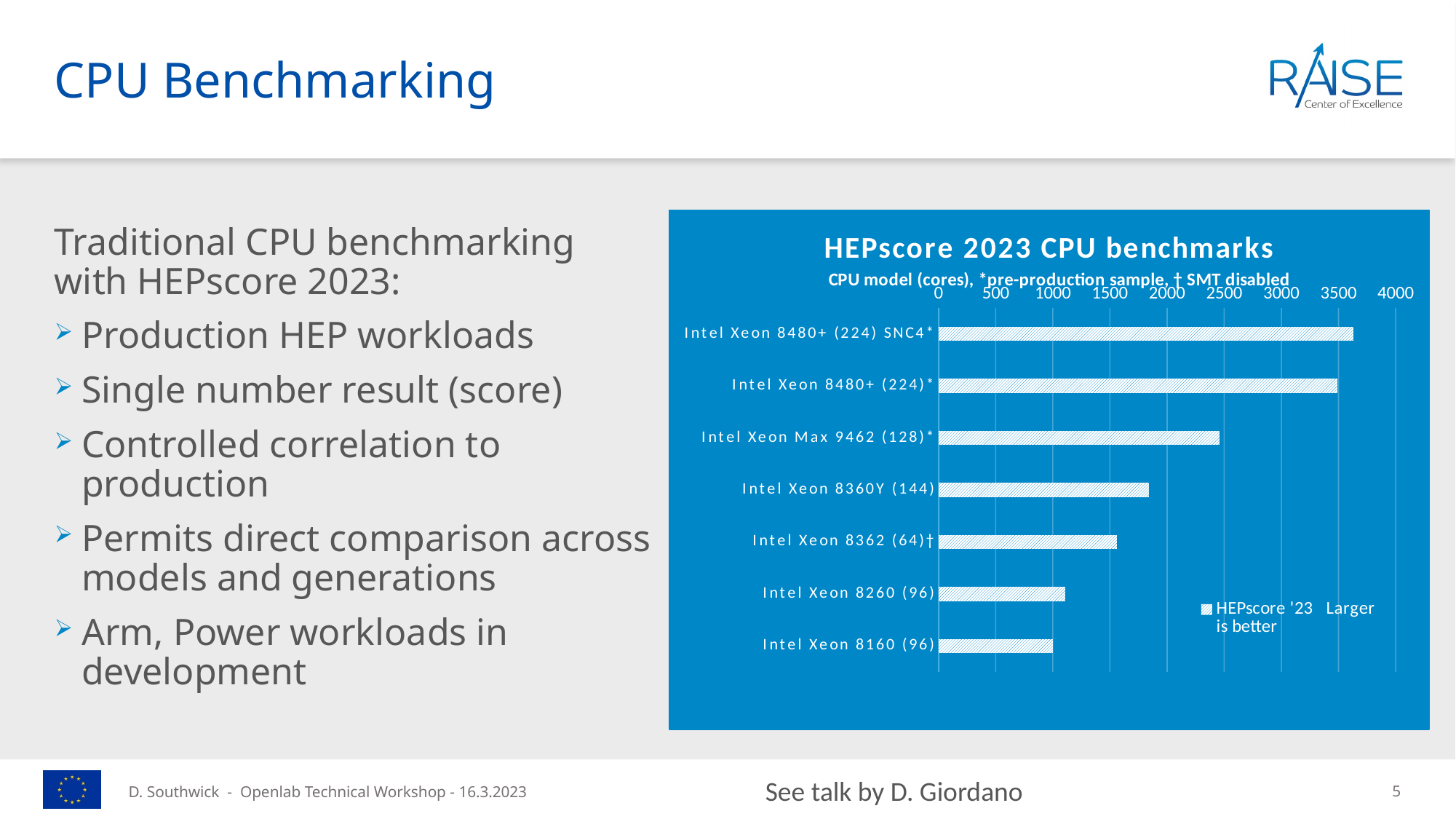
Is the value for Intel Xeon 8260 (96) greater or less than 1000? greater What is the name of the series shown in the chart legend? HEPscore '23 Larger is better Is the value for Intel Xeon 8360Y (144) greater or less than 1500? greater Is the value for Intel Xeon 8480+ (224) SNC4* greater or less than 3500? greater How many CPU models are plotted in the chart? 7 What kind of chart is shown on the slide? bar chart What is the title of the chart? HEPscore 2023 CPU benchmarks Which CPU model has the lowest HEPscore '23 value? Intel Xeon 8160 (96) Which CPU model has the highest HEPscore '23 value? Intel Xeon 8480+ (224) SNC4* How many series does the chart legend list? 1 Which has a larger HEPscore '23 value, Intel Xeon Max 9462 (128)* or Intel Xeon 8360Y (144)? Intel Xeon Max 9462 (128)*